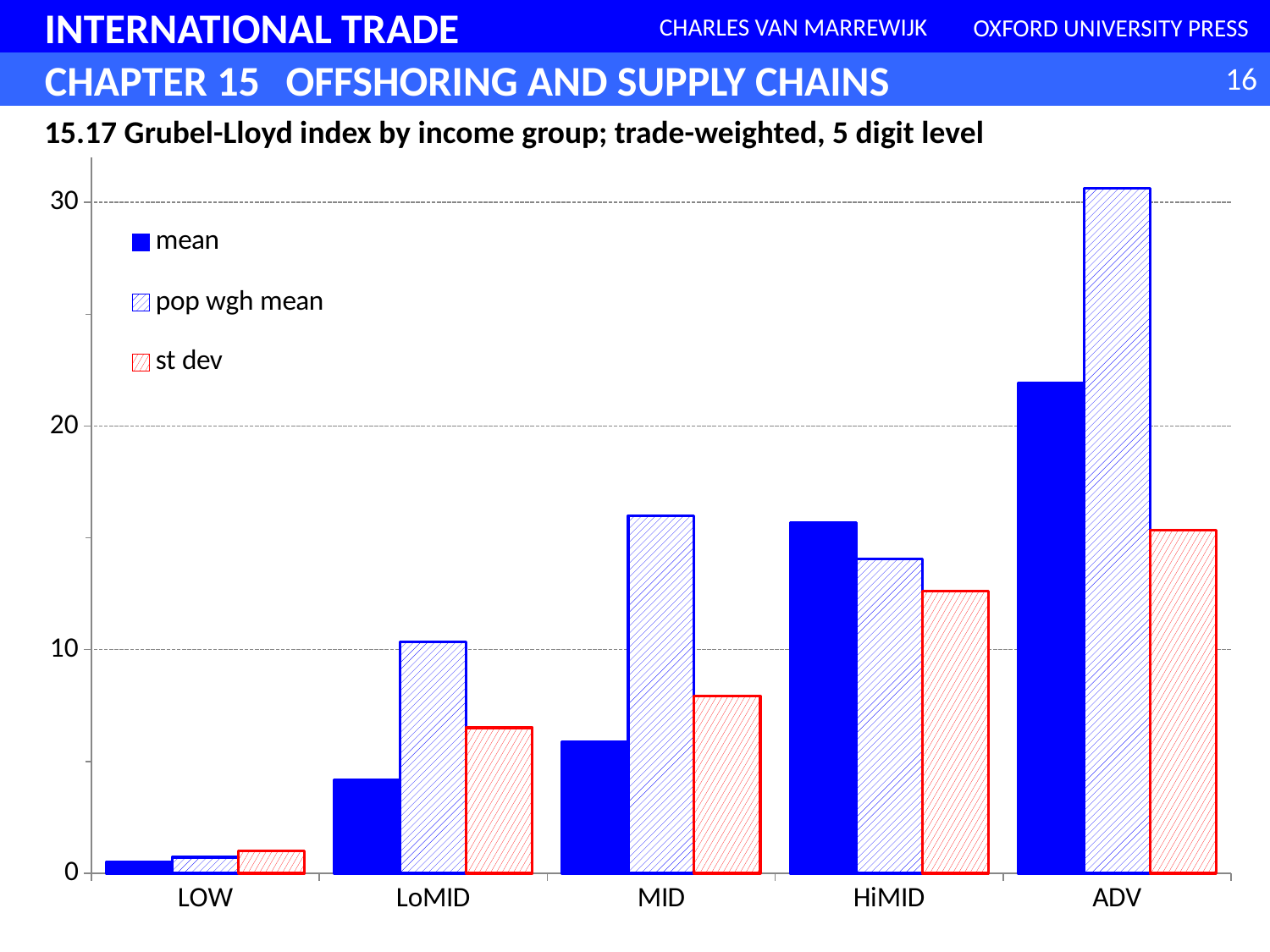
Is the mean value for HiMID greater or less than 10? greater For HiMID, which is larger: the mean or the pop wgh mean? mean Is the pop wgh mean value for MID greater or less than 20? less Which income group has the lowest mean value? LOW What is the title of the chart? 15.17 Grubel-Lloyd index by income group; trade-weighted, 5 digit level Is the pop wgh mean value for ADV greater or less than 30? greater How many series does the legend list? 3 What kind of chart is shown on the slide? bar chart Which income group has the highest mean value? ADV Does the mean value rise or fall moving from LOW to ADV along the x axis? rise How many income groups are shown on the x axis? 5